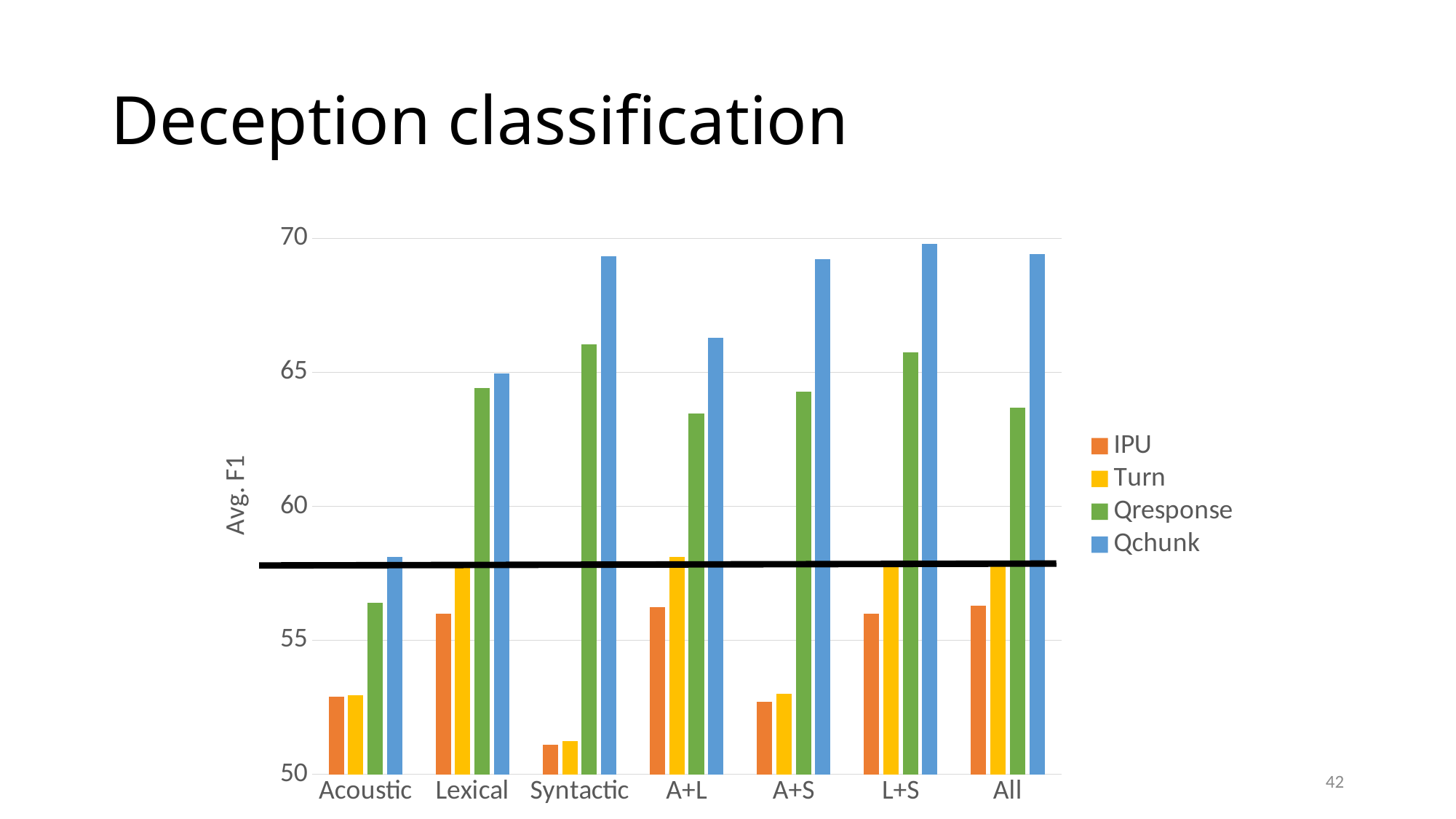
Is the Qresponse value for Syntactic greater or less than 65? greater Which series has the highest value in the Syntactic category? Qchunk Which is larger, the Qchunk value for Syntactic or the Qchunk value for A+L? Syntactic Which series has the lowest value in the Syntactic category? IPU Is the Turn value for Acoustic greater or less than 55? less In which category is the Qresponse value highest? Syntactic In which category is the Qchunk value lowest? Acoustic How many series does the legend list? 4 Is the Qchunk value for Acoustic greater or less than 60? less How many categories are shown on the x axis? 7 What is the label on the y axis? Avg. F1 What kind of chart is shown on the slide? bar chart